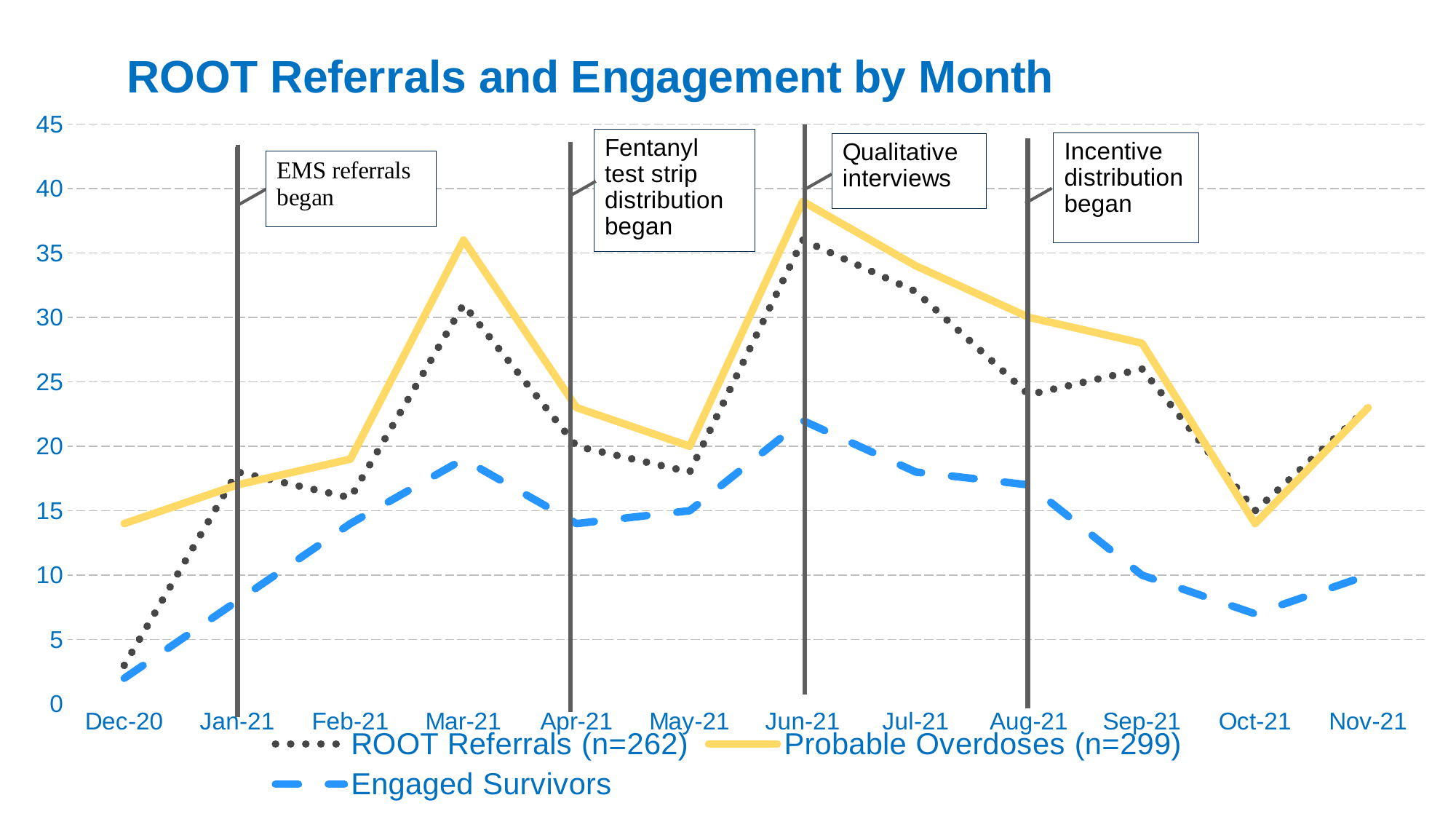
In which month do Probable Overdoses reach their highest value? Jun-21 How many series does the legend list? 3 In Jun-21, which is larger: Probable Overdoses or Engaged Survivors? Probable Overdoses Is the value for Engaged Survivors in Oct-21 greater or less than 10? less Is the value for ROOT Referrals in Dec-20 greater or less than 5? less What kind of chart is shown on the slide? line chart In which month do ROOT Referrals reach their highest value? Jun-21 How many months are plotted along the x axis? 12 What is the title of the chart? ROOT Referrals and Engagement by Month Is the value for Probable Overdoses in Mar-21 greater or less than 30? greater Do Probable Overdoses rise or fall from Jun-21 to Oct-21? fall In which month is the Engaged Survivors value lowest? Dec-20